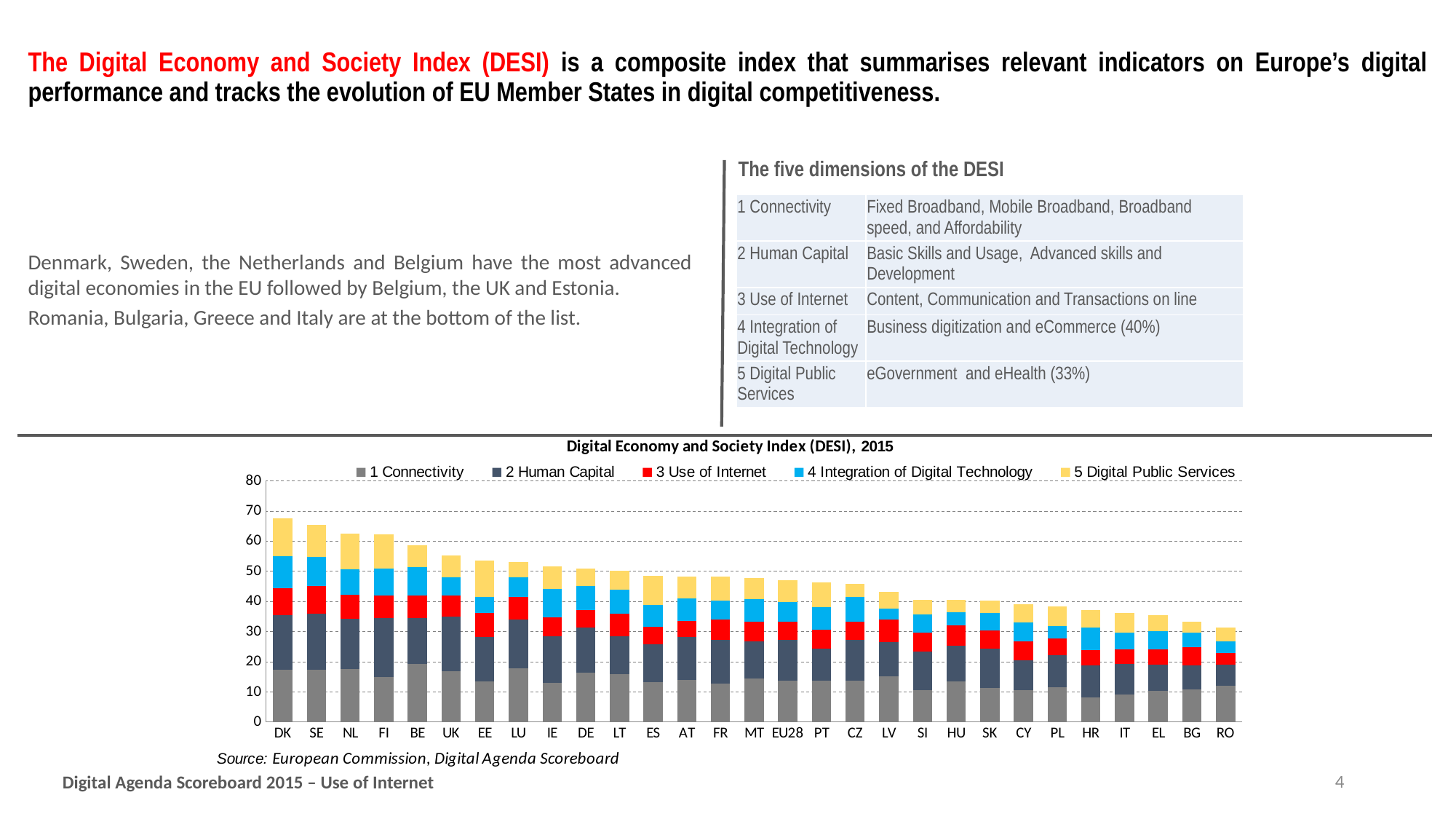
What kind of chart is shown on the slide? Stacked bar chart Is the total DESI value for BG greater or less than 30? greater What is the title of the chart? Digital Economy and Society Index (DESI), 2015 Is the total DESI value for DK greater or less than 60? greater Which series is shown in yellow in the chart legend? 5 Digital Public Services How many series does the legend of the DESI 2015 chart list? 5 Which has a larger total DESI score, SE or IT? SE Do the total DESI values rise or fall moving from left to right along the x axis? Fall Which category has the lowest total DESI score in the chart? RO Which category has the highest total DESI score in the chart? DK How many countries/categories are plotted along the x axis of the DESI 2015 chart? 29 Is the total DESI value for RO greater or less than 40? less